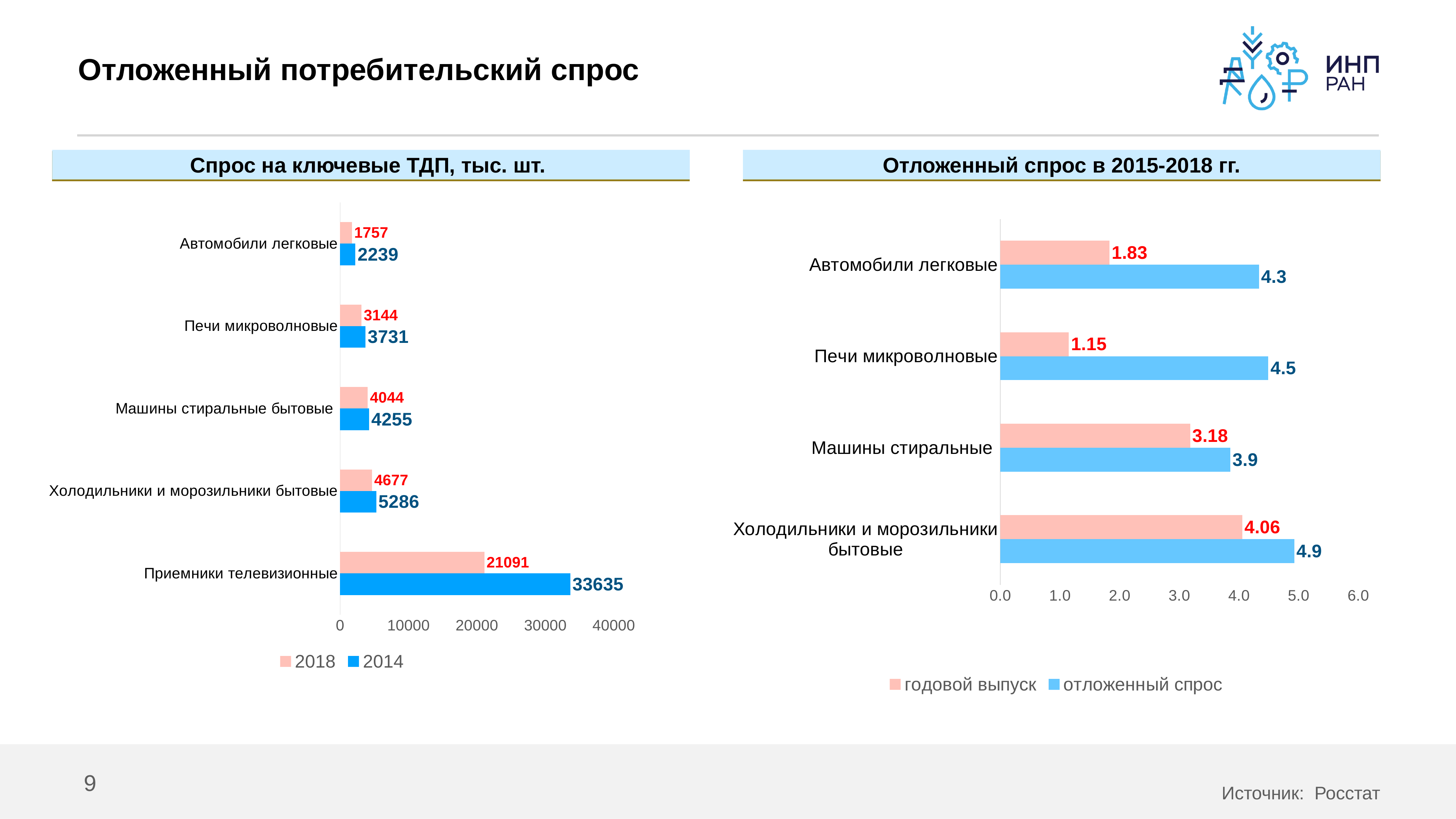
In the chart 'Отложенный спрос в 2015-2018 гг.', how many categories are shown? 4 In the chart 'Спрос на ключевые ТДП, тыс. шт.', which category has the highest 2018 value? Приемники телевизионные In the chart 'Спрос на ключевые ТДП, тыс. шт.', what is the difference between the 2014 and 2018 values for Холодильники и морозильники бытовые? 609 In the chart 'Отложенный спрос в 2015-2018 гг.', which category has the highest отложенный спрос value? Холодильники и морозильники бытовые In the chart 'Отложенный спрос в 2015-2018 гг.', which is larger for Автомобили легковые: годовой выпуск or отложенный спрос? отложенный спрос In the chart 'Спрос на ключевые ТДП, тыс. шт.', how many series does the legend list? 2 In the chart 'Спрос на ключевые ТДП, тыс. шт.', what is the 2014 value for Приемники телевизионные? 33635 In the chart 'Отложенный спрос в 2015-2018 гг.', what is the отложенный спрос value for Печи микроволновые? 4.5 In the chart 'Спрос на ключевые ТДП, тыс. шт.', which category has the lowest 2014 value? Автомобили легковые In the chart 'Отложенный спрос в 2015-2018 гг.', what is the годовой выпуск value for Машины стиральные? 3.18 What type of chart is 'Отложенный спрос в 2015-2018 гг.'? Bar chart In the chart 'Спрос на ключевые ТДП, тыс. шт.', what is the 2018 value for Автомобили легковые? 1757